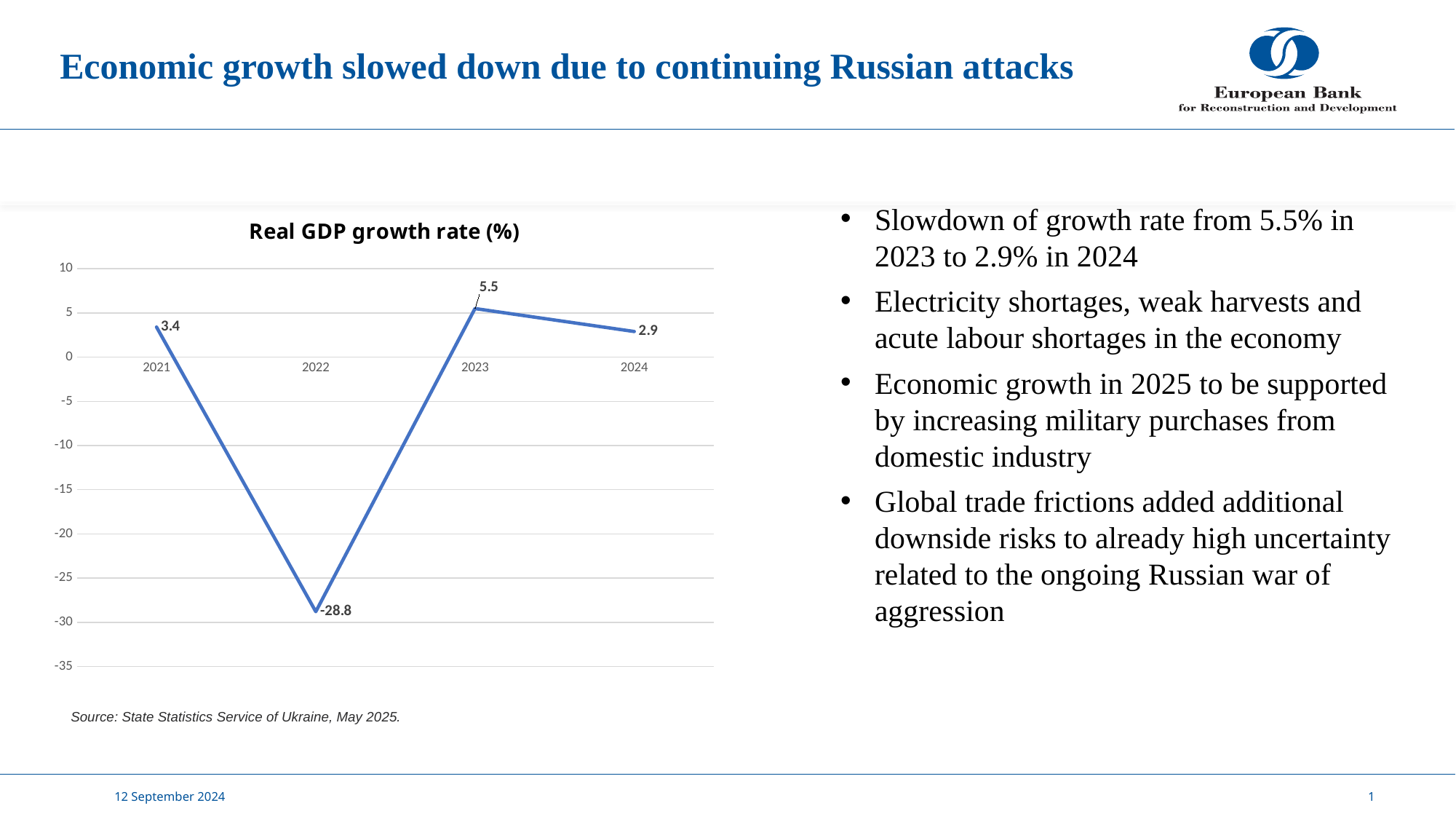
What is the difference between the real GDP growth rate in 2023 and in 2024? 2.6 What is the real GDP growth rate for 2023? 5.5 Is the value for 2022 greater or less than -25? less What is the title of the chart? Real GDP growth rate (%) What is the real GDP growth rate for 2022? -28.8 What is the real GDP growth rate for 2024? 2.9 What is the real GDP growth rate for 2021? 3.4 Which year has the highest real GDP growth rate? 2023 Which year has a higher real GDP growth rate, 2021 or 2024? 2021 Which year has the lowest real GDP growth rate? 2022 What kind of chart is shown on the slide? line chart How many years are plotted on the chart? 4